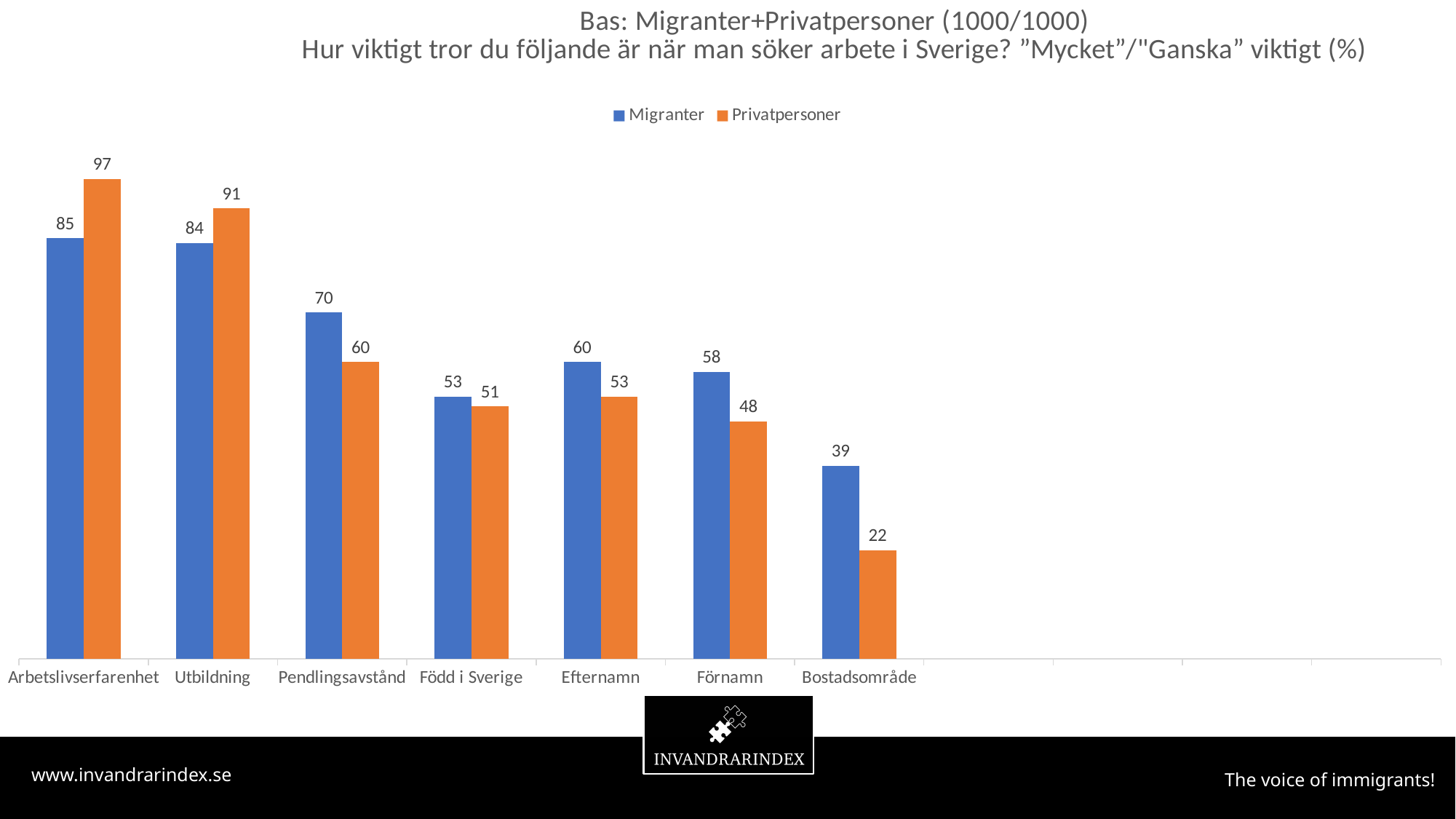
What is the difference between the Migranter and Privatpersoner values for Bostadsområde? 17 What kind of chart is shown on the slide? Bar chart How many categories are shown on the x axis? 7 Which colour represents the Privatpersoner series? Orange Which category has the highest Privatpersoner value? Arbetslivserfarenhet What is the difference between the Privatpersoner values for Arbetslivserfarenhet and Utbildning? 6 What is the Privatpersoner value for Utbildning? 91 Which category has the lowest Migranter value? Bostadsområde What is the Privatpersoner value for Bostadsområde? 22 What is the Migranter value for Pendlingsavstånd? 70 For Förnamn, which series has the larger value, Migranter or Privatpersoner? Migranter How many series does the legend list? 2